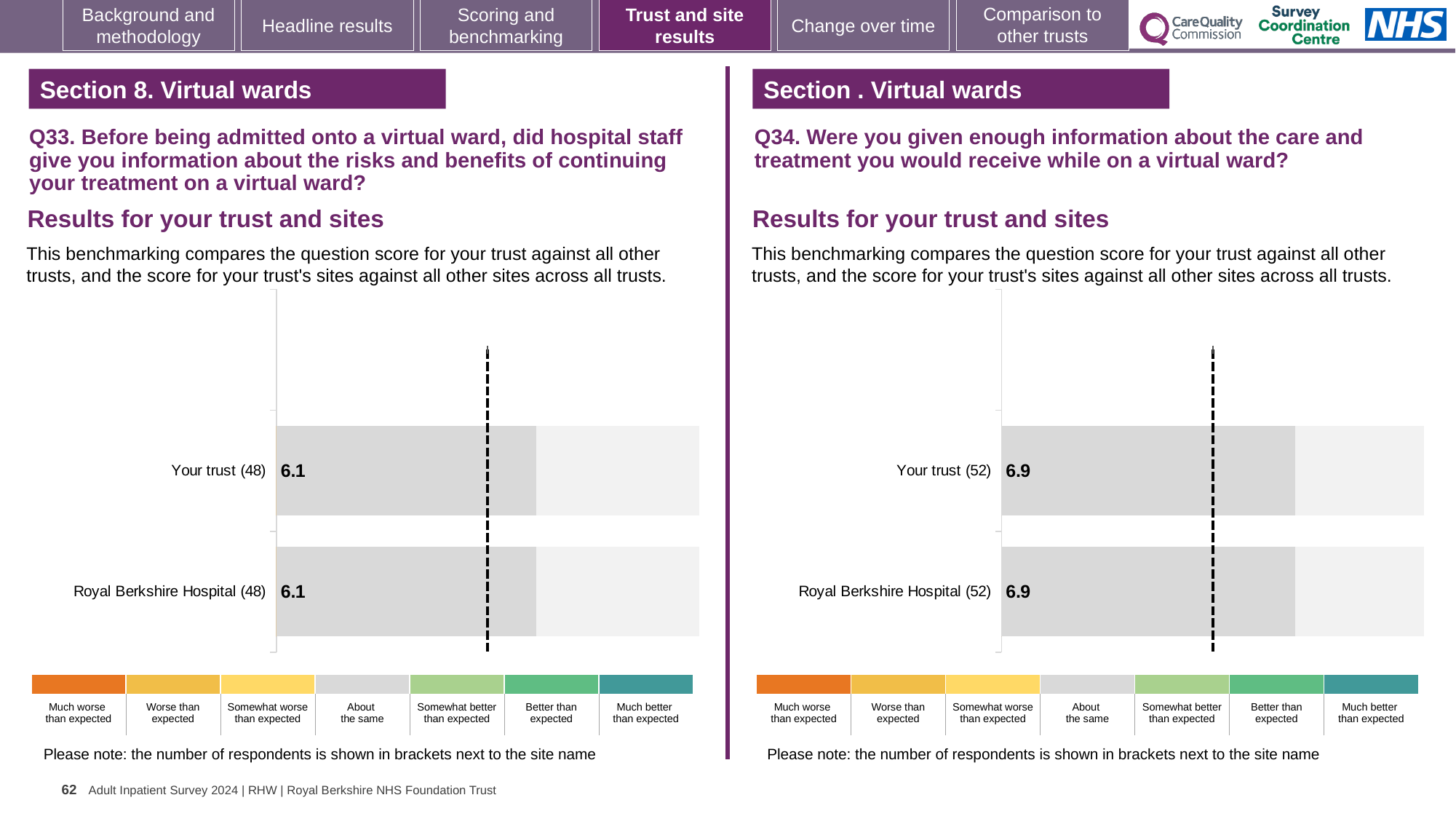
In the Q33 chart on the left, what is the score for Your trust? 6.1 How many bars are plotted in the Q34 chart on the right? 2 In the Q34 chart on the right, how many respondents are shown in brackets next to Royal Berkshire Hospital? 52 In the Q34 chart on the right, what is the score for Your trust? 6.9 What kind of chart is the Q33 chart on the left? Bar chart In the Q33 chart on the left, what is the difference between the score for Your trust and the score for Royal Berkshire Hospital? 0 In the Q33 chart on the left, what is the score for Royal Berkshire Hospital? 6.1 In the Q34 chart on the right, what is the difference between the score for Your trust and the score for Royal Berkshire Hospital? 0 In the Q34 chart on the right, what is the score for Royal Berkshire Hospital? 6.9 Is the Your trust score in the Q34 chart on the right larger or smaller than the Your trust score in the Q33 chart on the left? Larger How many bars are plotted in the Q33 chart on the left? 2 In the Q33 chart on the left, how many respondents are shown in brackets next to Your trust? 48